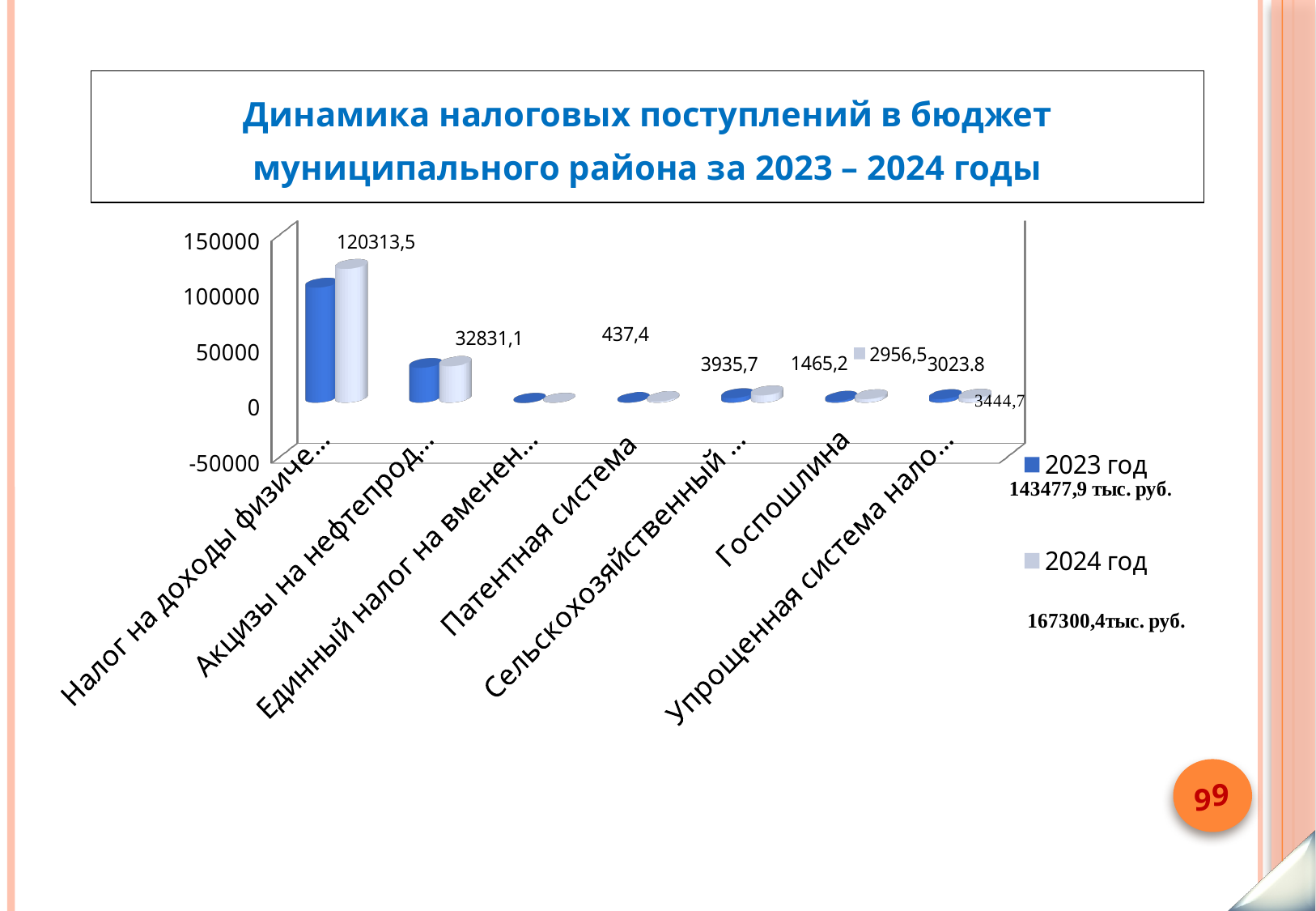
What total amount is printed under the legend entry 2024 год? 167300,4тыс. руб. How many categories are shown on the x axis? 7 Is the 2024 год value for Акцизы на нефтепрод... greater or less than 50000? less What is the 2024 год value for the category Акцизы на нефтепрод...? 32831,1 Is the 2024 год value for Налог на доходы физиче... greater or less than 100000? greater What is the 2024 год value for the category Налог на доходы физиче...? 120313,5 What are the two series names listed in the legend? 2023 год, 2024 год What kind of chart is shown on the slide? bar chart For the category Налог на доходы физиче..., which series has the larger value, 2023 год or 2024 год? 2024 год Which category has the highest values in the chart? Налог на доходы физиче... How many series does the legend list? 2